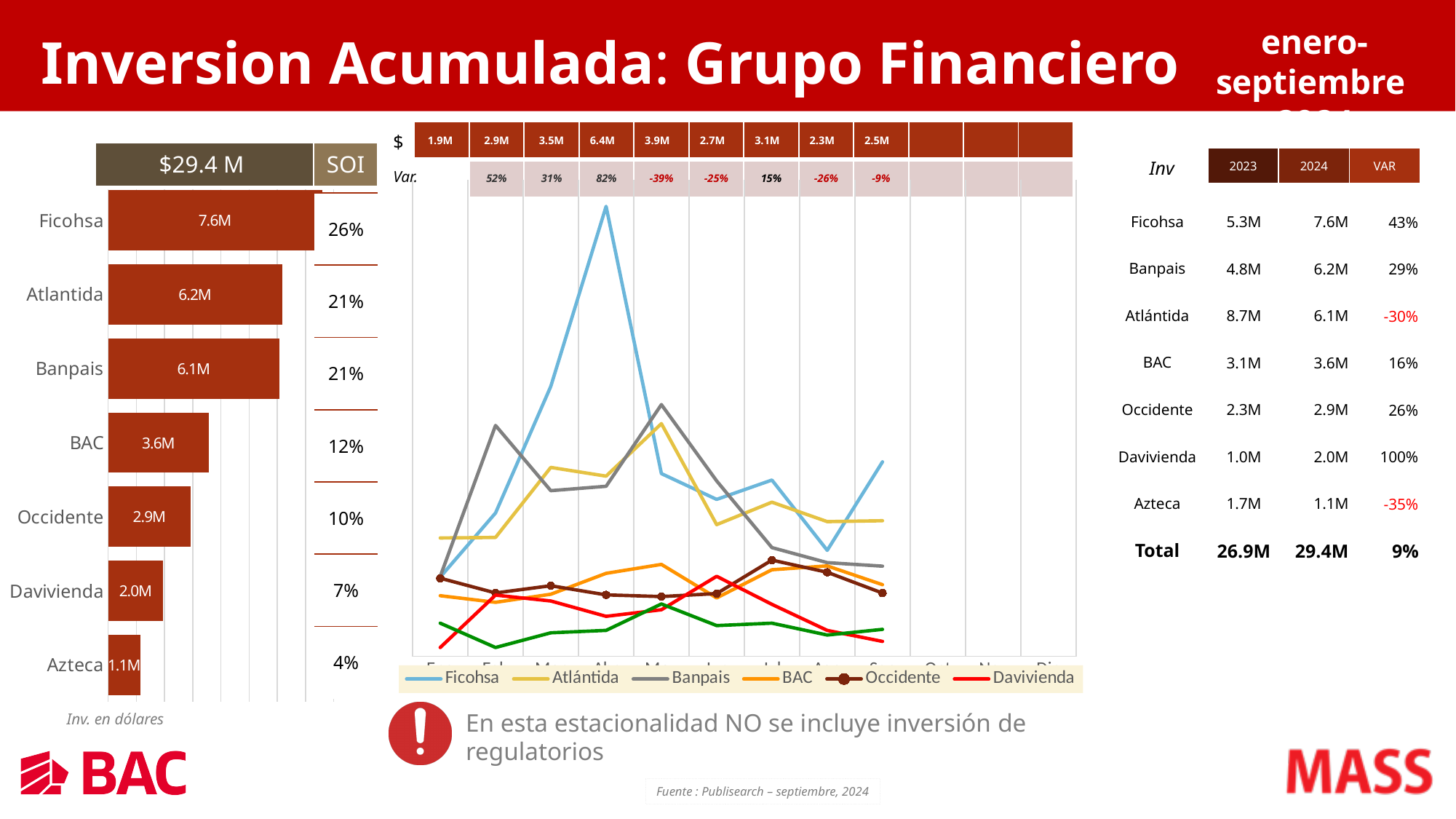
What kind of chart is the chart on the left of the slide? Bar chart In the bar chart on the left, which category has the highest value? Ficohsa In the bar chart on the left, what is the value for Occidente? 2.9M In the line chart in the middle, what colour is the Banpais line? Grey How many categories are shown in the bar chart on the left? 7 In the line chart in the middle, which series reaches the highest peak? Ficohsa In the bar chart on the left, what is the value for Ficohsa? 7.6M In the bar chart on the left, which category has the lowest value? Azteca In the bar chart on the left, what is the difference between the values for Ficohsa and BAC? 4.0M How many series does the legend of the line chart in the middle list? 6 In the bar chart on the left, which is larger, the value for BAC or the value for Davivienda? BAC In the bar chart on the left, what SOI percentage is shown next to Banpais? 21%